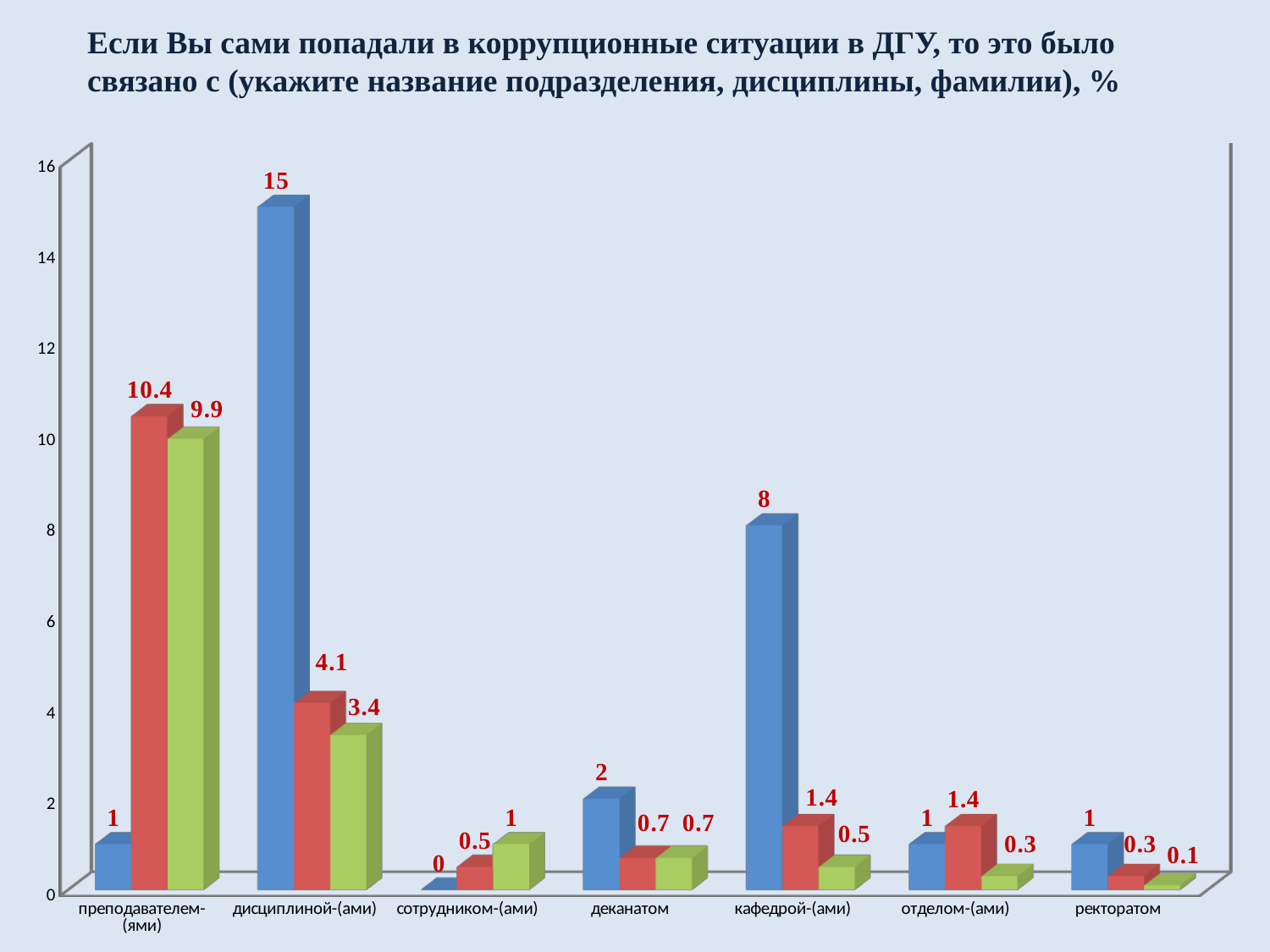
Which is larger for отделом-(ами): the blue bar or the red bar? the red bar Which category has the lowest green bar? ректоратом What is the value of the green bar for кафедрой-(ами)? 0.5 Which category has the highest blue bar? дисциплиной-(ами) What is the value of the blue bar for сотрудником-(ами)? 0 What is the value of the red bar for преподавателем-(ями)? 10.4 What is the value of the blue bar for дисциплиной-(ами)? 15 What is the difference between the blue bar for дисциплиной-(ами) and the blue bar for кафедрой-(ами)? 7 What is the difference between the red and green bars for преподавателем-(ями)? 0.5 How many categories are shown on the x axis? 7 What kind of chart is shown on the slide? bar chart How many bars are shown for each category? 3